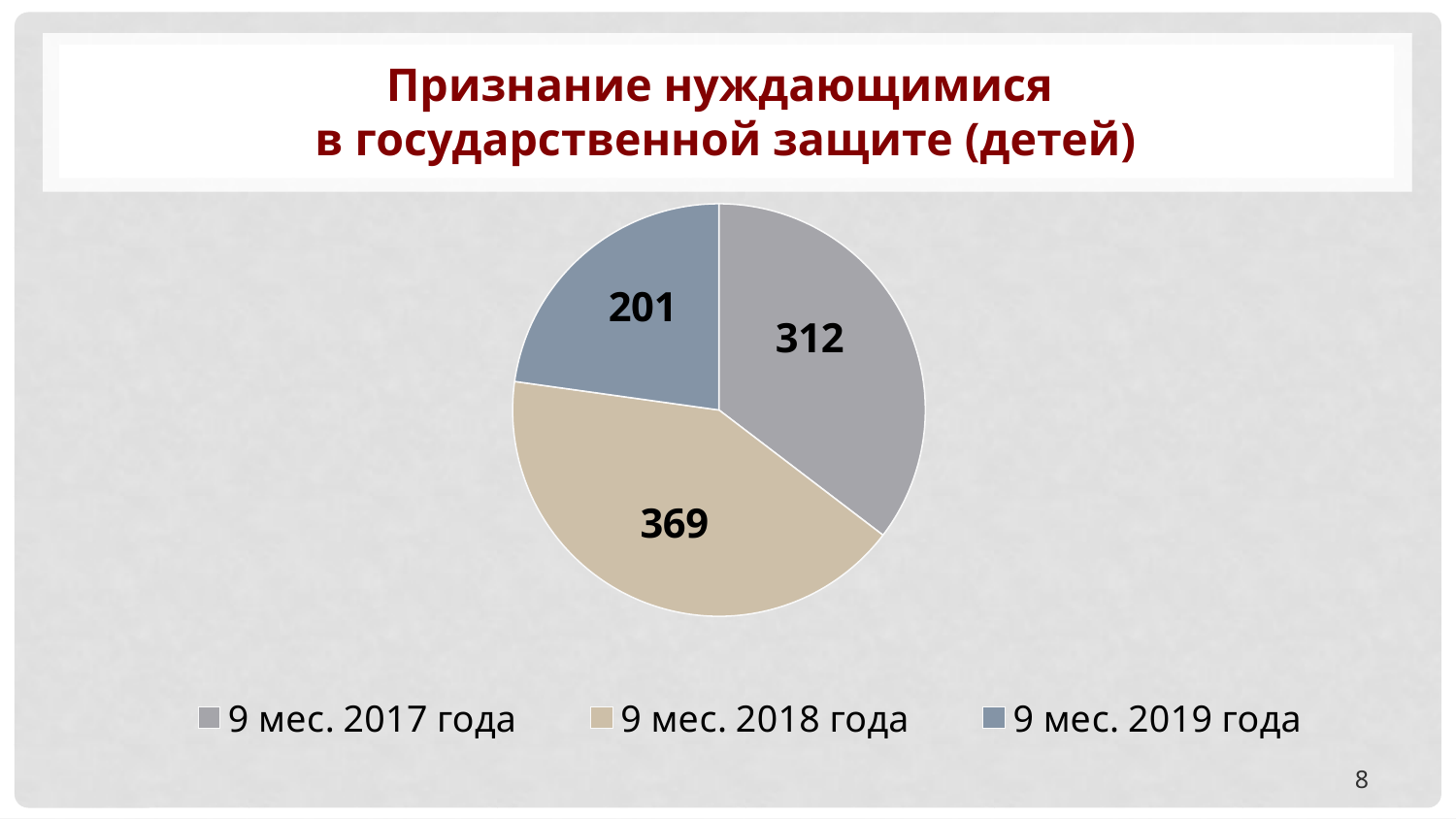
Which is larger, the value for 9 мес. 2017 года or for 9 мес. 2019 года? 9 мес. 2017 года What is the difference between the values for 9 мес. 2017 года and 9 мес. 2019 года? 111 What is the difference between the values for 9 мес. 2018 года and 9 мес. 2017 года? 57 Which period has the largest slice of the pie? 9 мес. 2018 года What is the total of all three slices in the pie chart? 882 What is the title of the chart on the slide? Признание нуждающимися в государственной защите (детей) Which period has the smallest slice of the pie? 9 мес. 2019 года How many slices does the pie chart have? 3 What value is shown for 9 мес. 2019 года? 201 What value is shown for 9 мес. 2018 года? 369 What value is shown for 9 мес. 2017 года? 312 What type of chart is shown on the slide? Pie chart